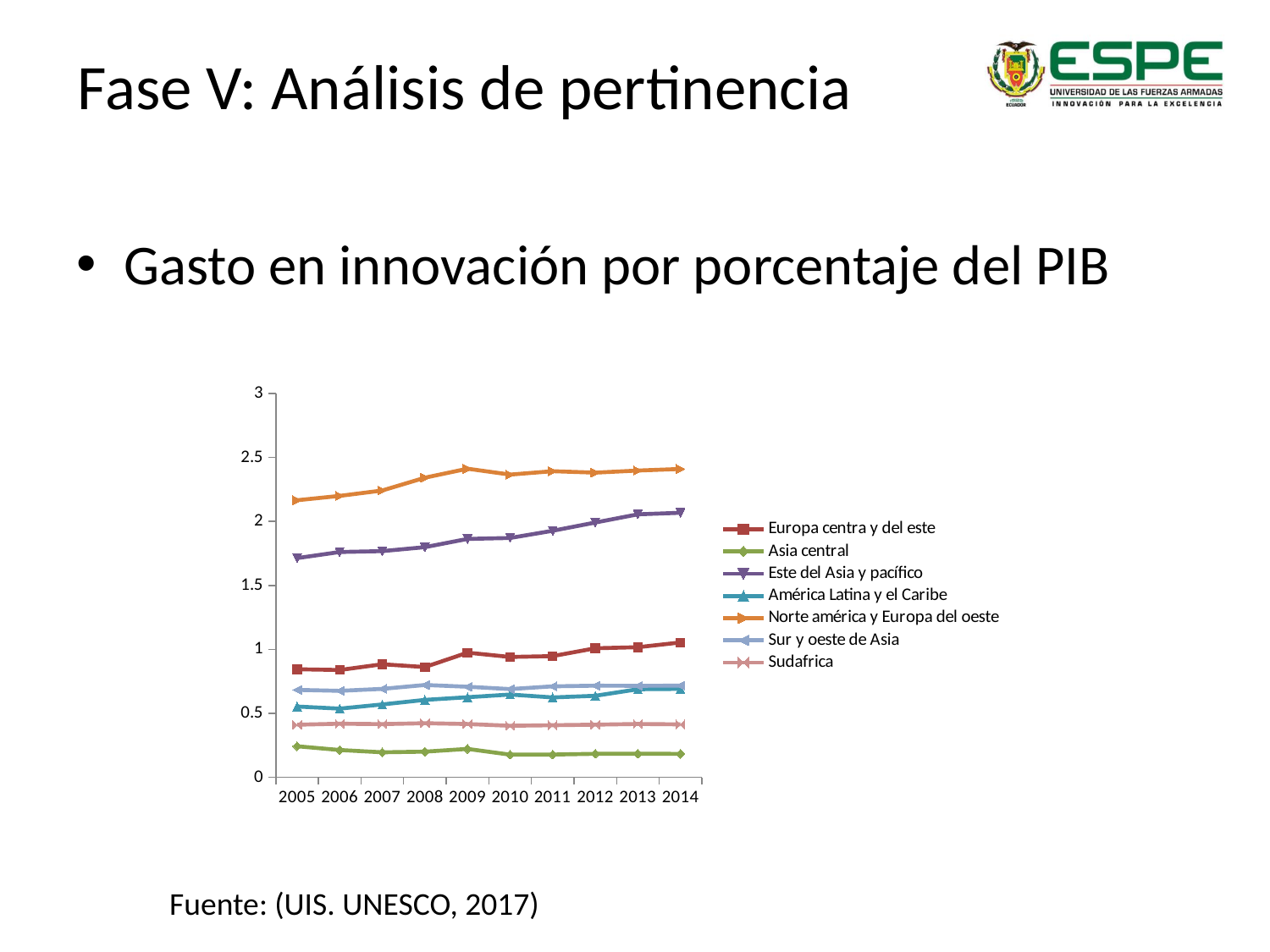
In 2010, which is larger: Europa centra y del este or América Latina y el Caribe? Europa centra y del este Is the value for Sudafrica in 2010 greater or less than 0.5? less Which series has the lowest values across the chart? Asia central What kind of chart is shown on the slide? line chart Do the values for Este del Asia y pacífico rise or fall from 2005 to 2014? rise Is the value for Norte américa y Europa del oeste in 2005 greater or less than 2? greater Is the value for Europa centra y del este in 2005 greater or less than 1? less How many series does the legend list? 7 How many years are shown on the x axis? 10 Which series has the highest values across the chart? Norte américa y Europa del oeste Which series is drawn in orange? Norte américa y Europa del oeste